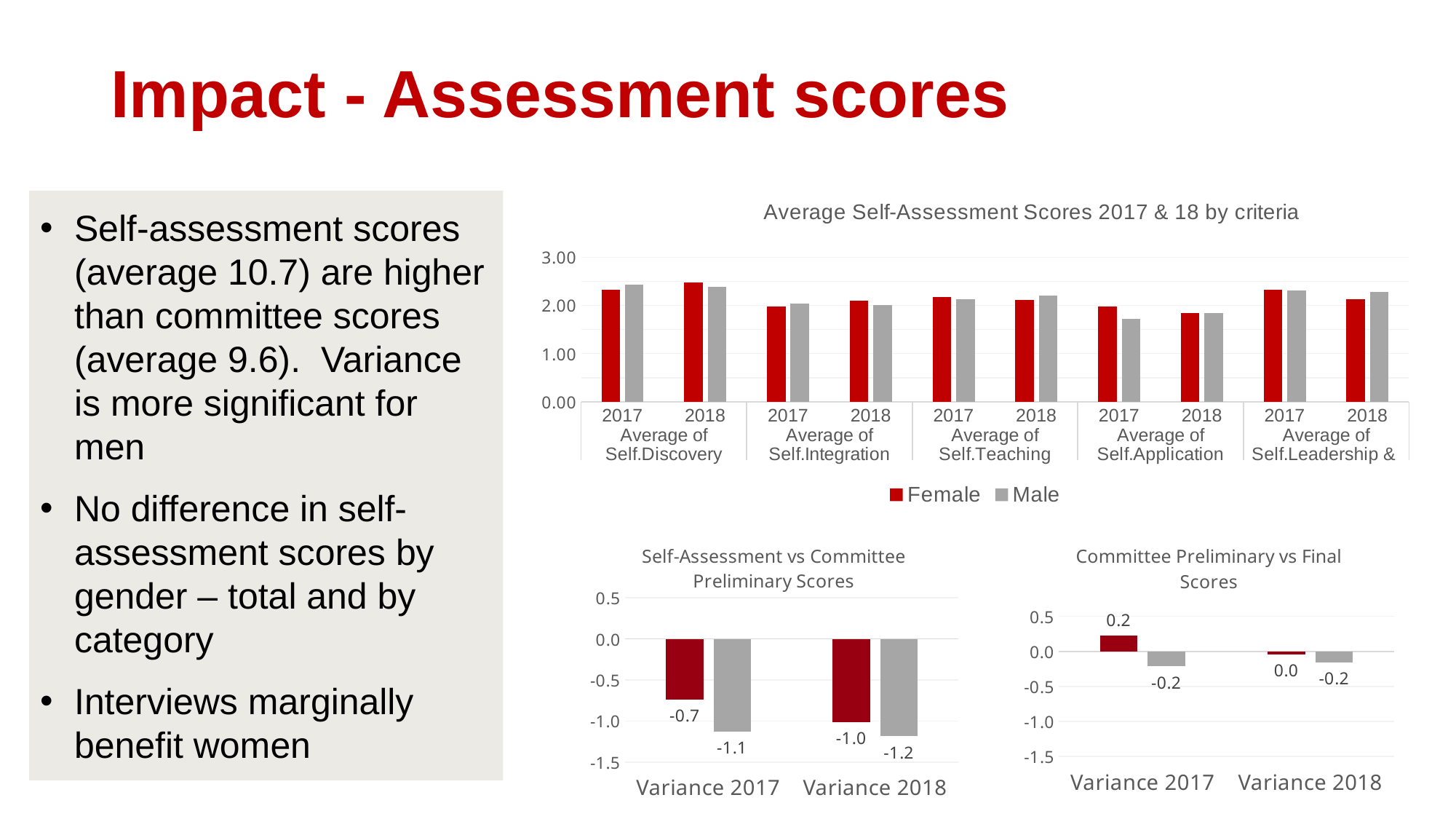
In the 'Average Self-Assessment Scores 2017 & 18 by criteria' chart, which series is shown in red? Female In the 'Committee Preliminary vs Final Scores' chart, which bar has the highest value? Red bar for Variance 2017 In the 'Self-Assessment vs Committee Preliminary Scores' chart, what is the value of the red bar for Variance 2017? -0.7 In the 'Average Self-Assessment Scores 2017 & 18 by criteria' chart, is the Male value for 2017 Average of Self.Application greater or less than 2.00? less What type of chart is the 'Average Self-Assessment Scores 2017 & 18 by criteria' chart? Bar chart In the 'Committee Preliminary vs Final Scores' chart, what is the value of the red bar for Variance 2017? 0.2 In the 'Self-Assessment vs Committee Preliminary Scores' chart, what is the value of the grey bar for Variance 2018? -1.2 How many series does the legend of the 'Average Self-Assessment Scores 2017 & 18 by criteria' chart list? 2 In the 'Average Self-Assessment Scores 2017 & 18 by criteria' chart, for 2017 Average of Self.Application, which is larger, Female or Male? Female In the 'Average Self-Assessment Scores 2017 & 18 by criteria' chart, is the Female value for 2017 Average of Self.Discovery greater or less than 2.00? greater In the 'Self-Assessment vs Committee Preliminary Scores' chart, what is the difference between the red and grey bars for Variance 2017? 0.4 In the 'Average Self-Assessment Scores 2017 & 18 by criteria' chart, how many criteria groups are shown on the x axis? 5